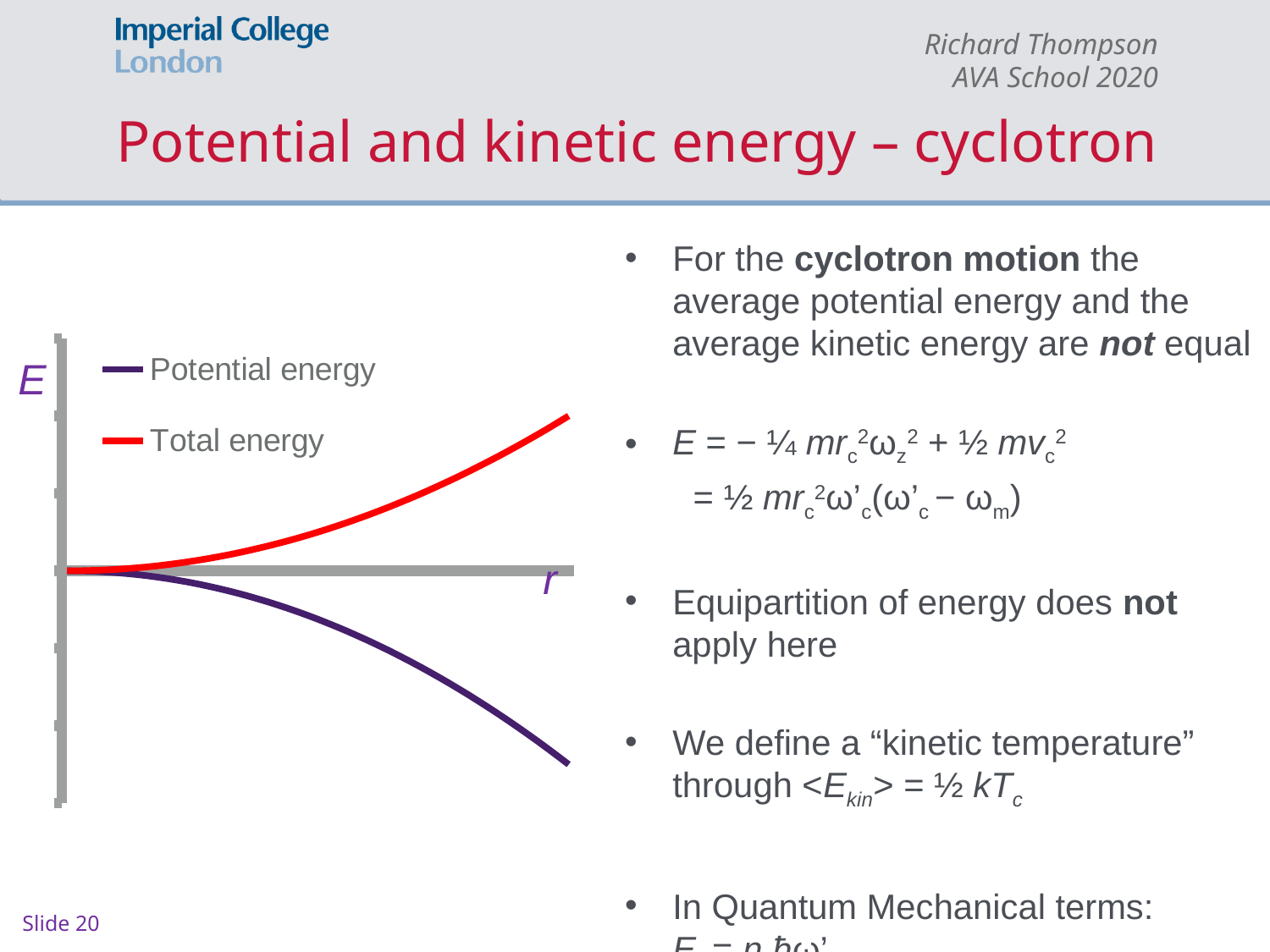
What label is on the vertical axis of the chart? E Does the Potential energy curve rise or fall as r increases? fall What colour is the Total energy line in the chart? red How many series does the chart's legend list? 2 Does the Total energy curve rise or fall as r increases? rise At the right-hand end of the chart, which series has the higher value: Potential energy or Total energy? Total energy Which series in the chart takes negative values as r increases? Potential energy What label is on the horizontal axis of the chart? r What kind of chart is shown on the slide? line chart